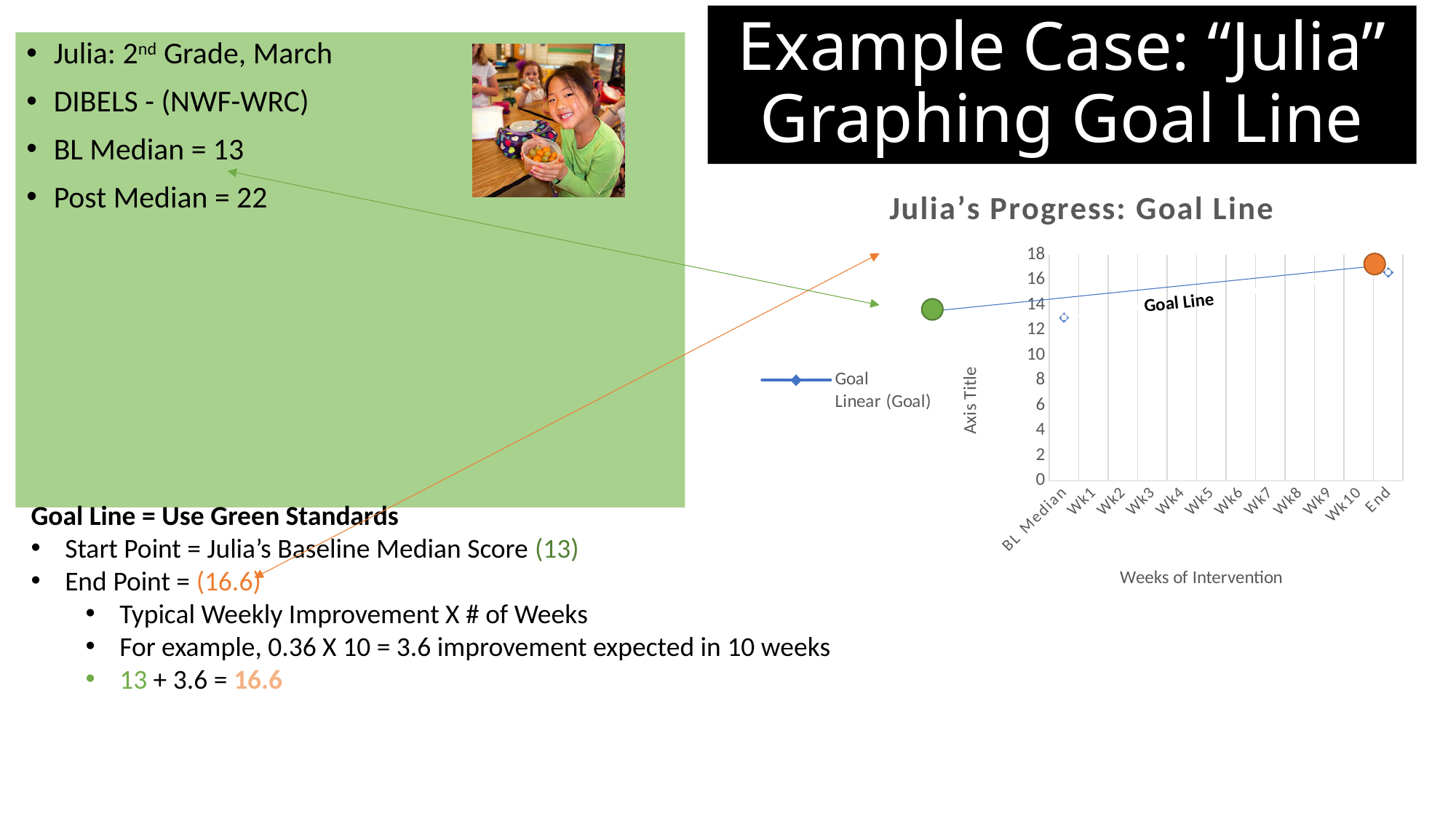
How many categories are shown on the x axis of the chart? 12 Does the goal line rise or fall from BL Median to End? rise Which plotted point is higher, BL Median or End? End What is the highest tick value shown on the chart's y axis? 18 How many entries does the chart's legend list? 2 Is the value plotted for End greater or less than 16? greater Is the value plotted for BL Median greater or less than 12? greater What is the title of the chart on the slide? Julia's Progress: Goal Line What kind of chart is shown on the slide? line chart Is the value plotted for End greater or less than 18? less What are the two entries in the chart's legend? Goal and Linear (Goal)